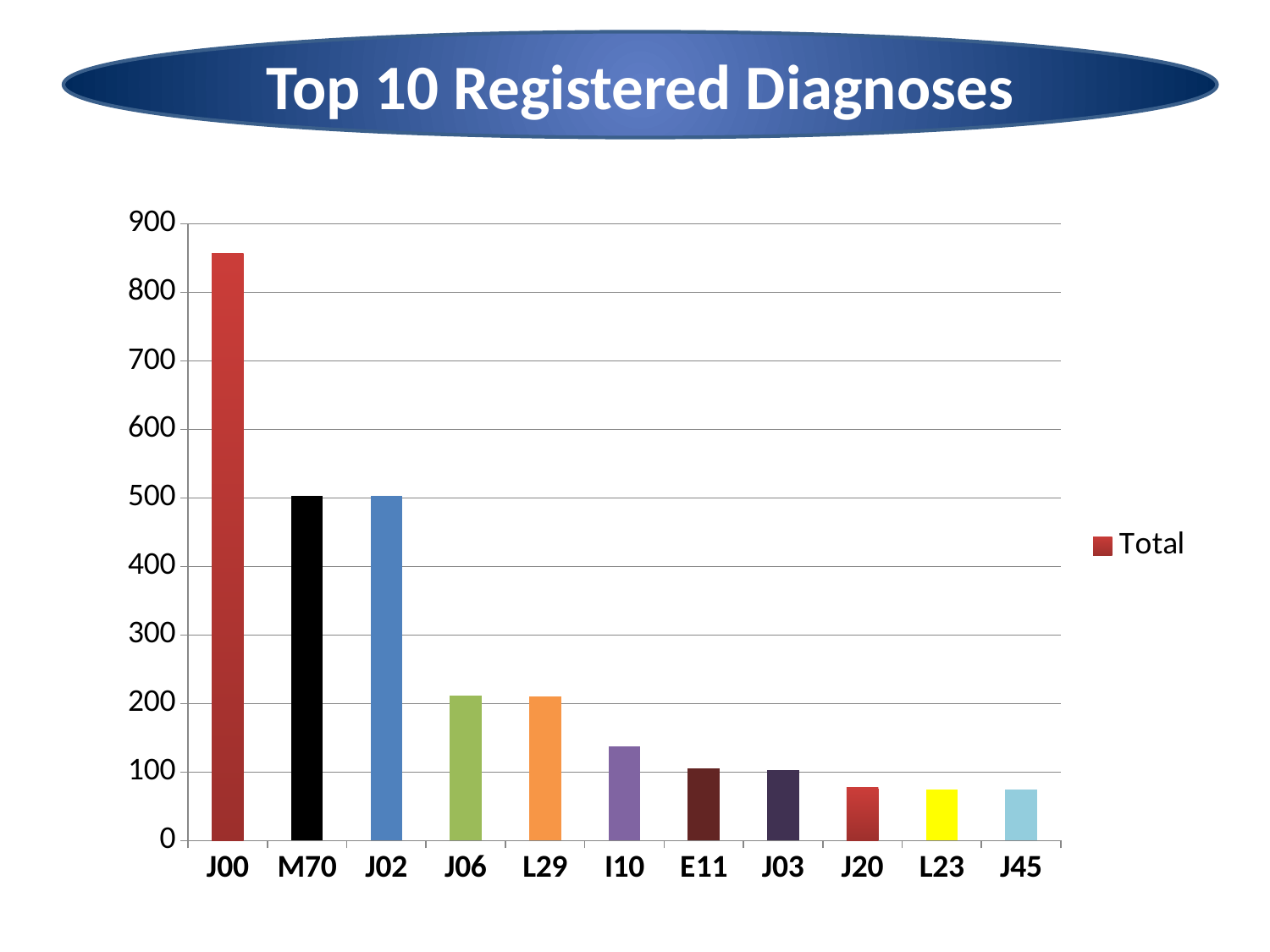
Is the value for J06 greater or less than 200? greater Which is larger, the value for J00 or the value for M70? J00 Do the values generally rise or fall from left to right along the x axis? fall How many diagnosis categories are plotted on the x axis? 11 Is the value for J20 greater or less than 100? less What is the title of the chart? Top 10 Registered Diagnoses Is the value for I10 greater or less than 100? greater How many series does the legend list? 1 Which diagnosis has the highest value? J00 What kind of chart is shown on the slide? bar chart Which is larger, the value for J02 or the value for J06? J02